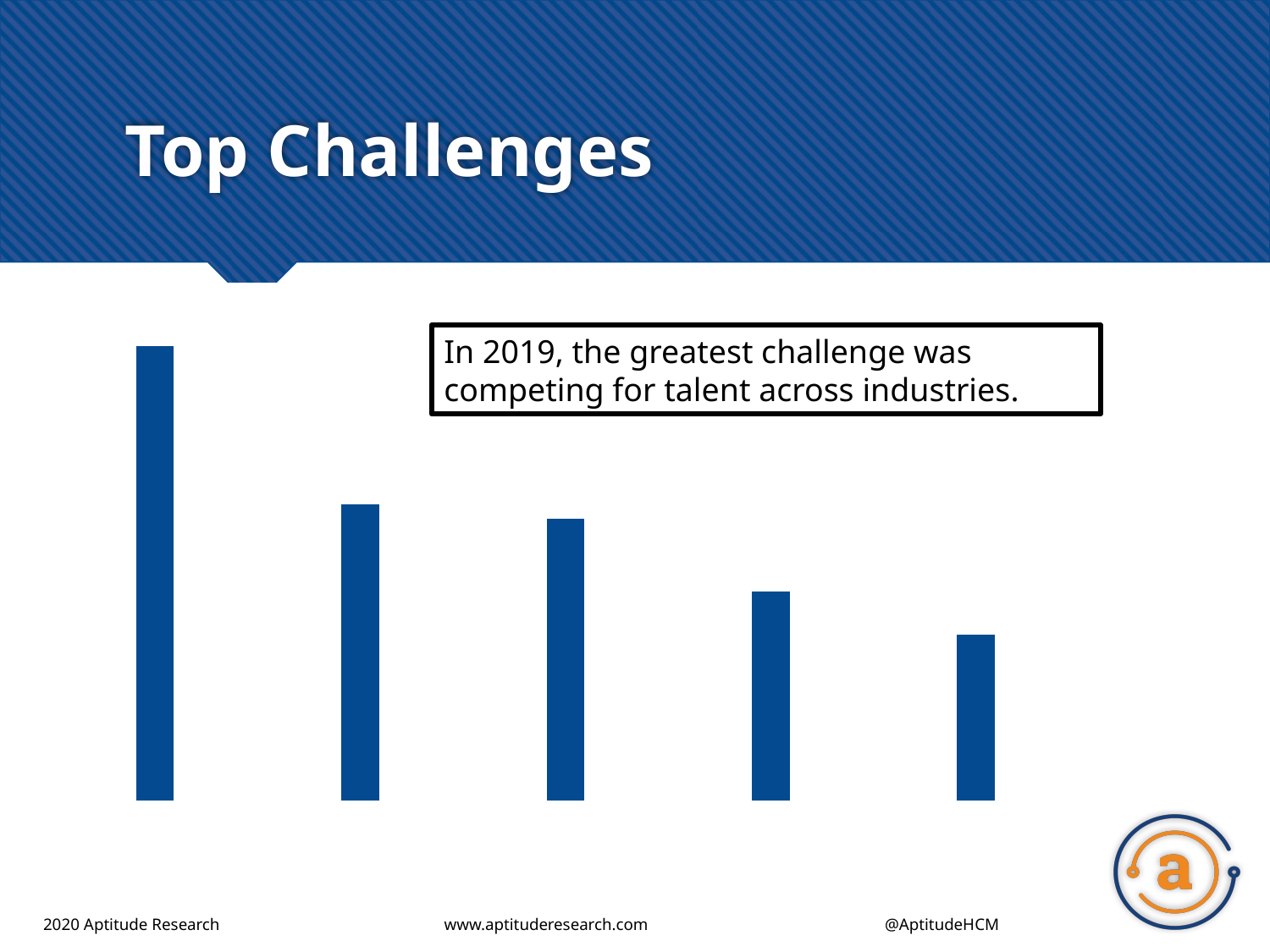
What kind of chart is shown on the slide? bar chart Which is larger, the second bar from the left or the fourth bar from the left? the second bar from the left How many bars does the chart show? 5 What colour are the bars in the chart? blue Which is larger, the third bar from the left or the fifth bar from the left? the third bar from the left What is the title of the slide containing the chart? Top Challenges Which bar is the tallest: the leftmost or the rightmost? the leftmost Which bar is the shortest: the leftmost or the rightmost? the rightmost Do the bar values rise or fall from left to right across the chart? fall